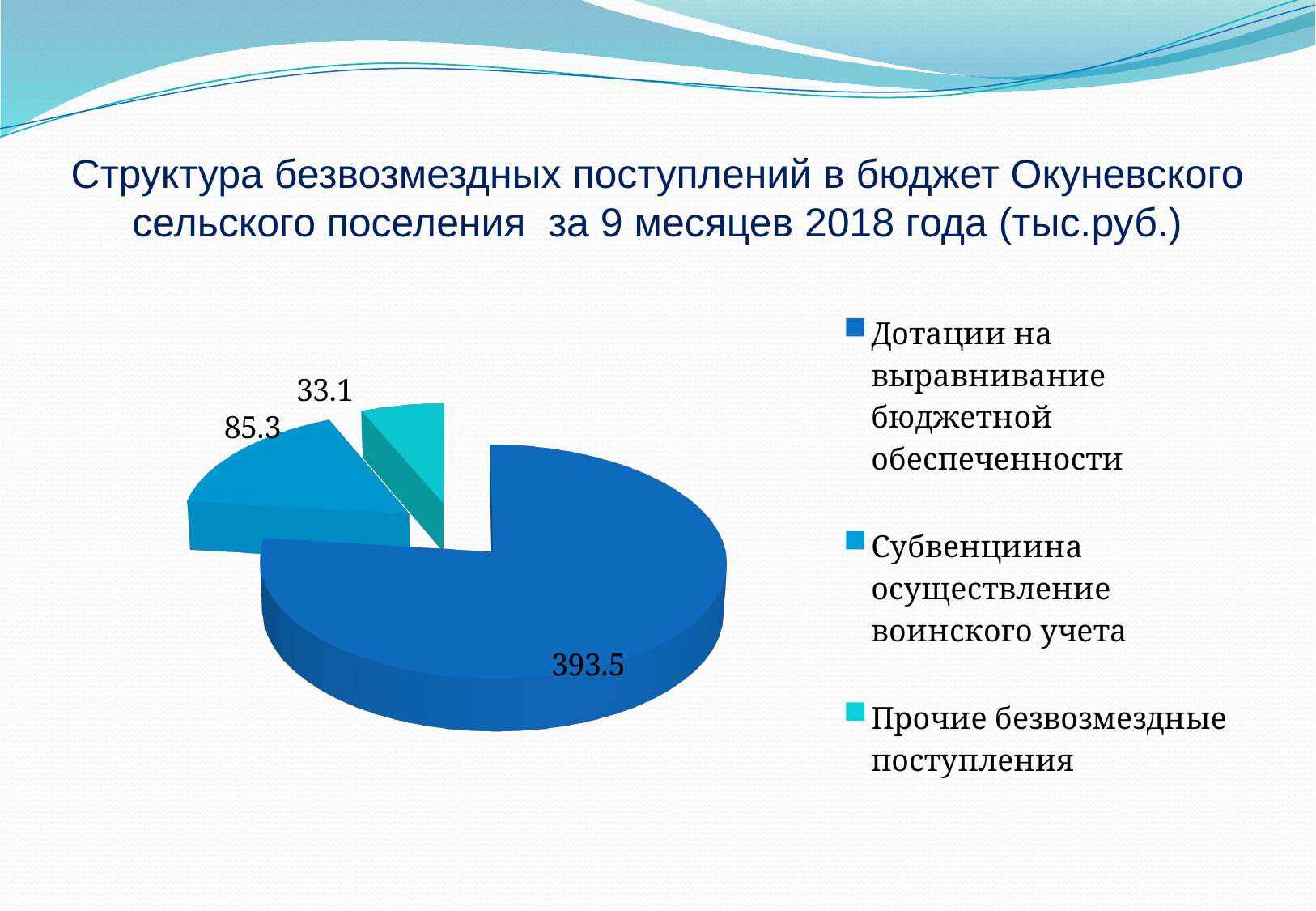
What is the value for Дотации на выравнивание бюджетной обеспеченности? 393.5 Which category has the largest slice of the pie? Дотации на выравнивание бюджетной обеспеченности What type of chart is shown on the slide? Pie chart What is the total of all slices in the pie chart? 511.9 What is the difference between the value for Субвенции на осуществление воинского учета and the value for Прочие безвозмездные поступления? 52.2 What is the value for Субвенции на осуществление воинского учета? 85.3 How many slices does the pie chart have? 3 What is the difference between the value for Дотации на выравнивание бюджетной обеспеченности and the value for Субвенции на осуществление воинского учета? 308.2 Which category has the smallest slice of the pie? Прочие безвозмездные поступления What colour is the slice for Прочие безвозмездные поступления? Cyan (light turquoise) What is the value for Прочие безвозмездные поступления? 33.1 Which is larger: Субвенции на осуществление воинского учета or Прочие безвозмездные поступления? Субвенции на осуществление воинского учета